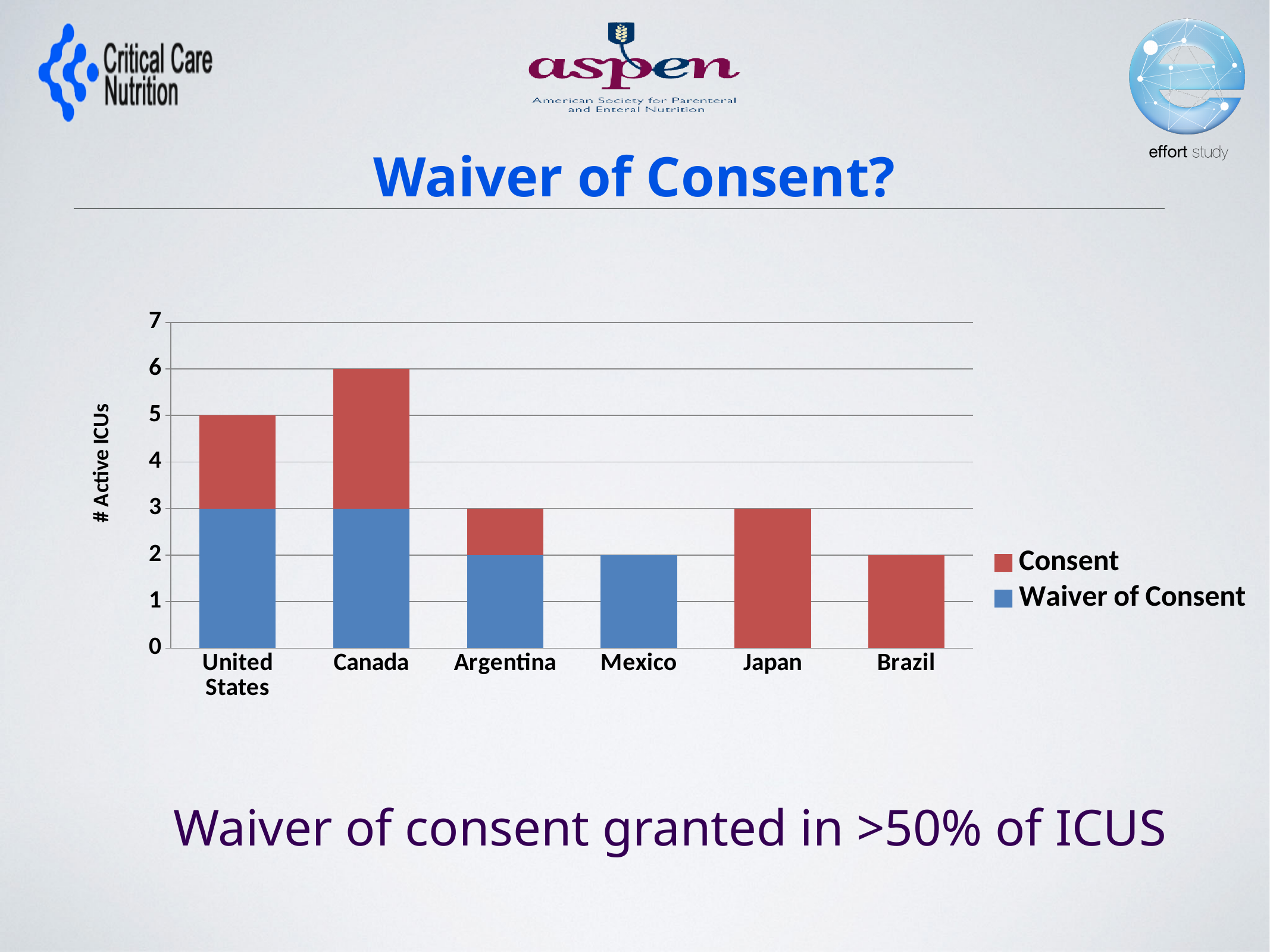
How many active ICUs with Consent does Japan have? 3 Which has more total active ICUs, Argentina or Brazil? Argentina What is the label of the vertical axis of the chart? # Active ICUs Which country has the tallest total bar in the chart? Canada How many active ICUs with Waiver of Consent does Mexico have? 2 How many countries are shown on the x axis of the chart? 6 How many series does the chart legend list? 2 What is the total number of active ICUs for Canada? 6 What kind of chart is shown on the slide? Stacked bar chart How many active ICUs with Waiver of Consent does the United States have? 3 What is the total number of active ICUs for the United States? 5 What is the difference in total active ICUs between Canada and the United States? 1